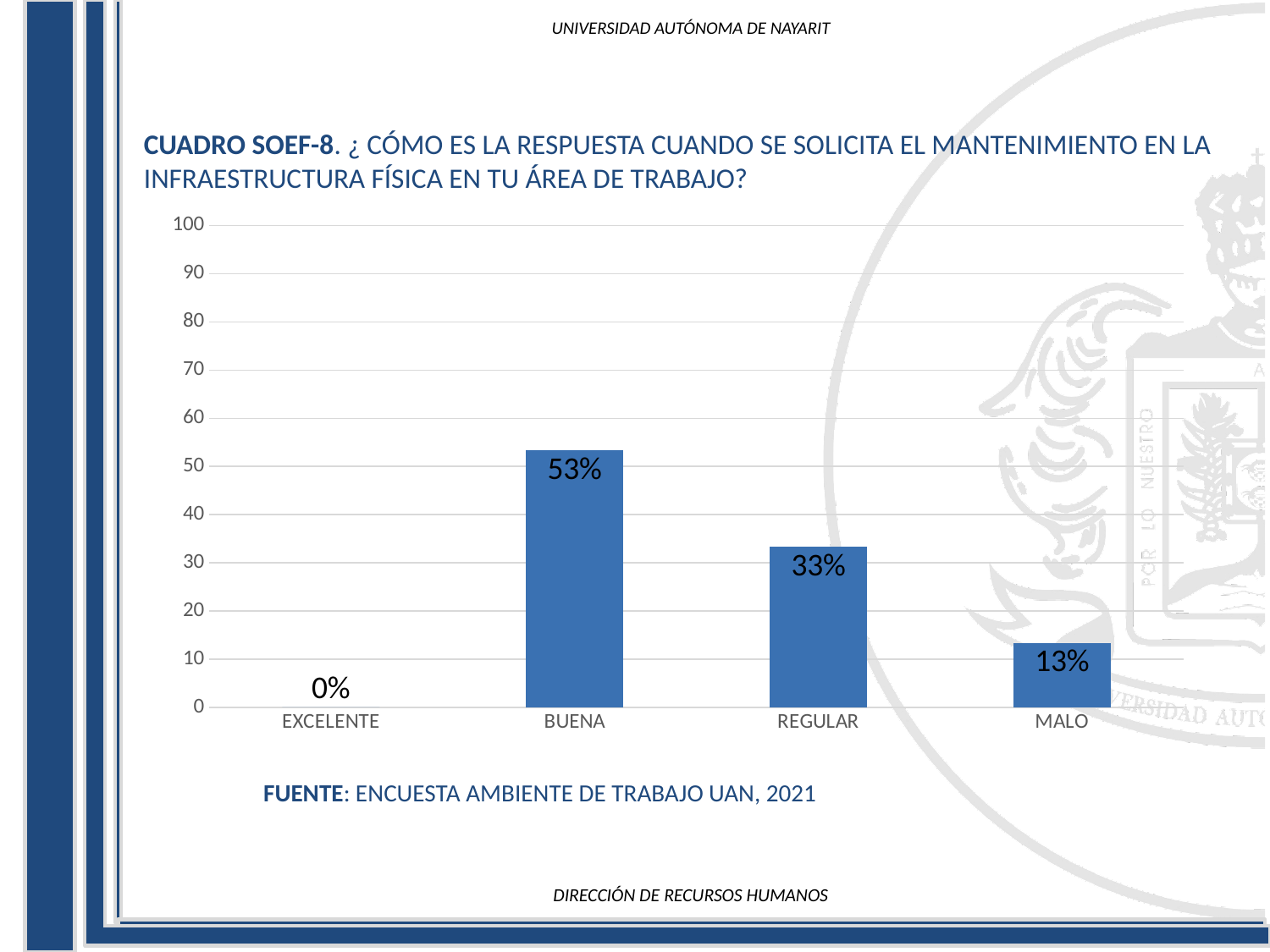
What is the value for BUENA? 53% What is the value for REGULAR? 33% Which is larger, the value for REGULAR or the value for MALO? REGULAR What kind of chart is shown on the slide? bar chart What is the difference between the values for BUENA and REGULAR? 20% What is the value for MALO? 13% Is the value for BUENA greater or less than 50? greater How many categories are shown on the x axis? 4 What is the difference between the values for REGULAR and MALO? 20% Which category has the lowest value? EXCELENTE Which category has the highest value? BUENA What is the value for EXCELENTE? 0%